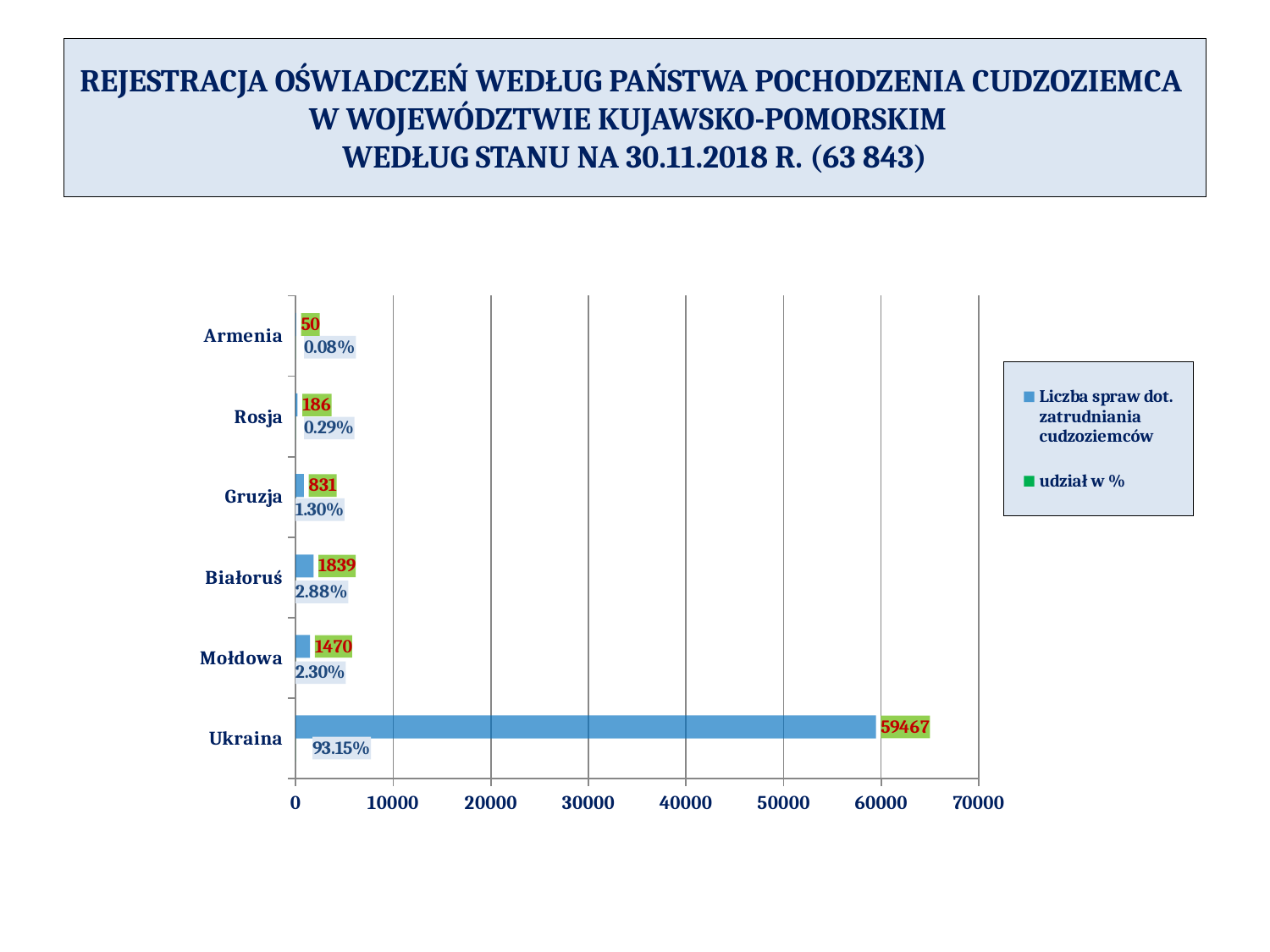
What is the difference in the number of cases between Białoruś and Mołdowa? 369 How many countries are shown on the chart? 6 Which country has the lowest number of cases? Armenia What is the number of cases (Liczba spraw) for Ukraina? 59467 Is the number of cases for Ukraina greater or less than 50000? greater What is the share in % (udział w %) for Armenia? 0.08% How many series does the legend list? 2 What is the number of cases (Liczba spraw) for Gruzja? 831 Which has more cases, Gruzja or Rosja? Gruzja What is the share in % (udział w %) for Białoruś? 2.88% What kind of chart is shown on the slide? bar chart Which country has the highest number of cases? Ukraina